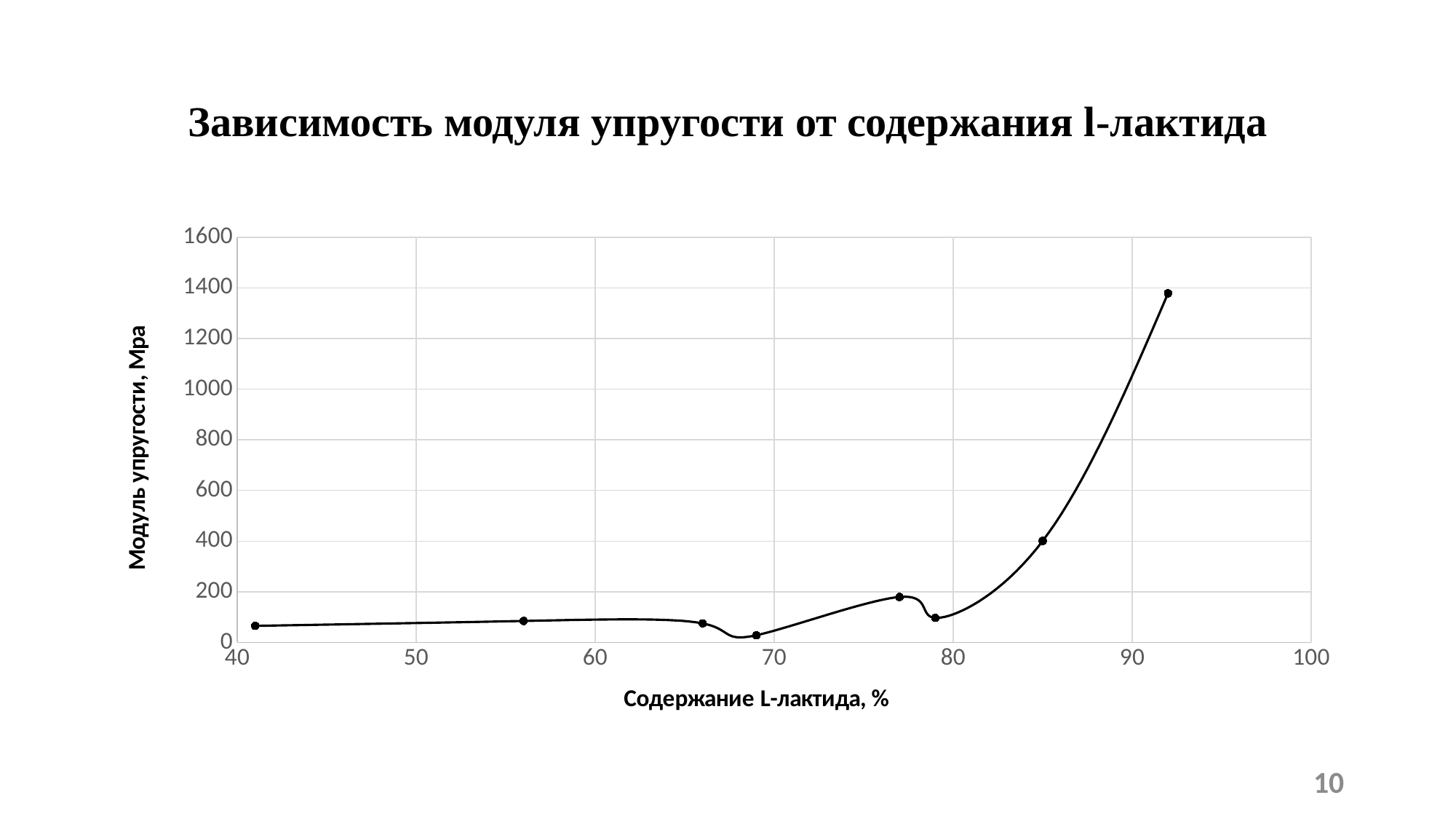
What is the title of the chart on the slide? Зависимость модуля упругости от содержания l-лактида What is the label of the y axis? Модуль упругости, Mpa Does the elastic modulus overall rise or fall as L-lactide content increases from 80% to 92%? rise How many data points are plotted on the chart? 8 Which data point has the highest elastic modulus: the leftmost or the rightmost? the rightmost Which is larger: the elastic modulus at about 85% L-lactide or at about 92% L-lactide? at about 92% Is the value of the rightmost data point (near 92% L-lactide) greater or less than 1200? greater Is the value of the data point near 69% L-lactide greater or less than 100? less Which data point has the lowest elastic modulus: the one near 69% or the one near 85% L-lactide? the one near 69% Is the value of the leftmost data point (near 41% L-lactide) greater or less than 200? less What kind of chart is shown on the slide? line chart